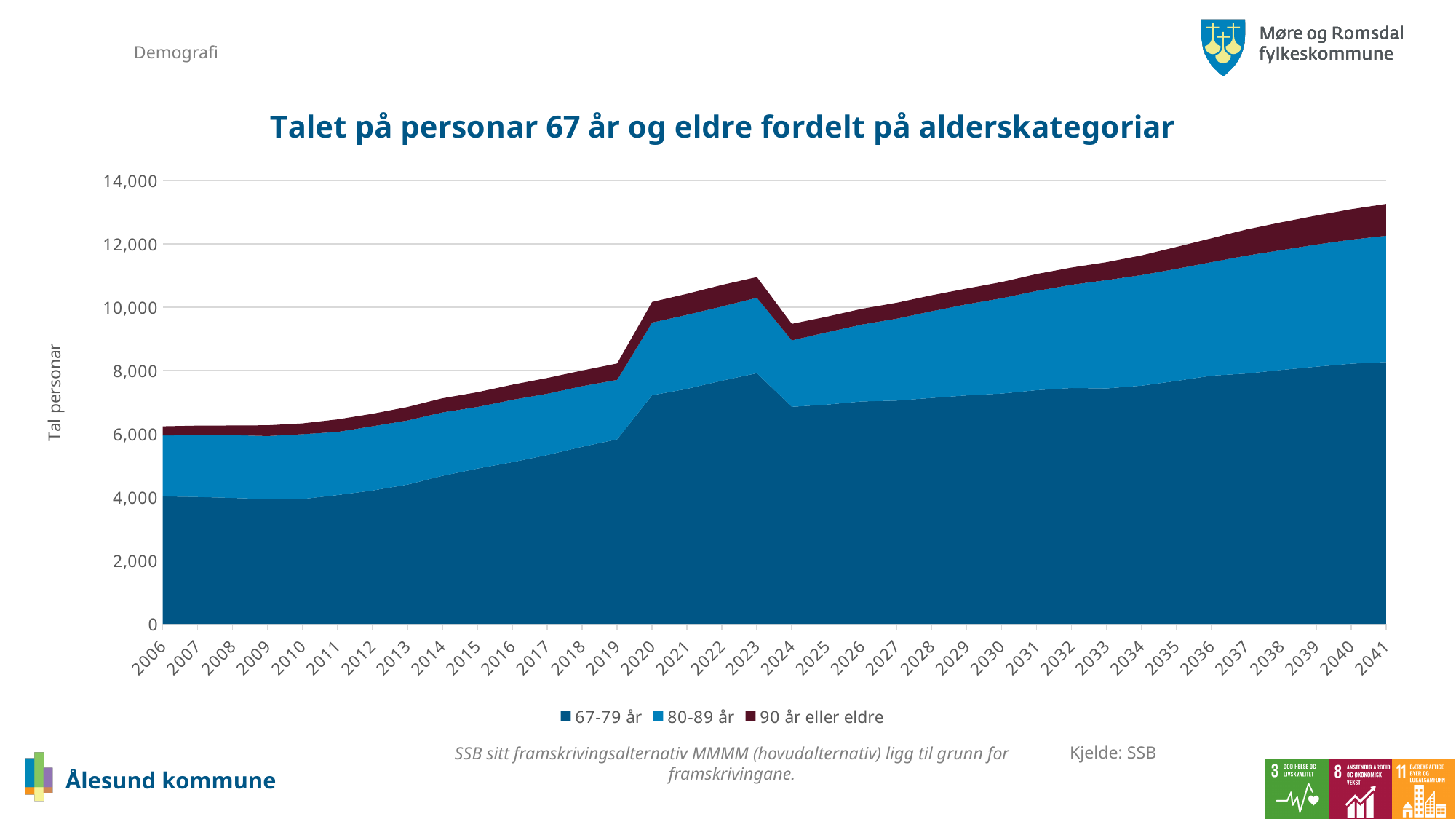
What is the title of the chart? Talet på personar 67 år og eldre fordelt på alderskategoriar Does the total number of persons 67 år og eldre generally rise or fall from 2006 to 2041? Rise What kind of chart is shown on the slide? Stacked area chart Is the total value for 2041 greater or less than 12,000? greater Is the total value for 2013 greater or less than 6,000? greater How many series does the legend list? 3 Which year has the highest total number of persons 67 år og eldre? 2041 Is the total value for 2024 greater or less than 10,000? less What is the label on the y axis? Tal personar How many years are shown along the x axis? 36